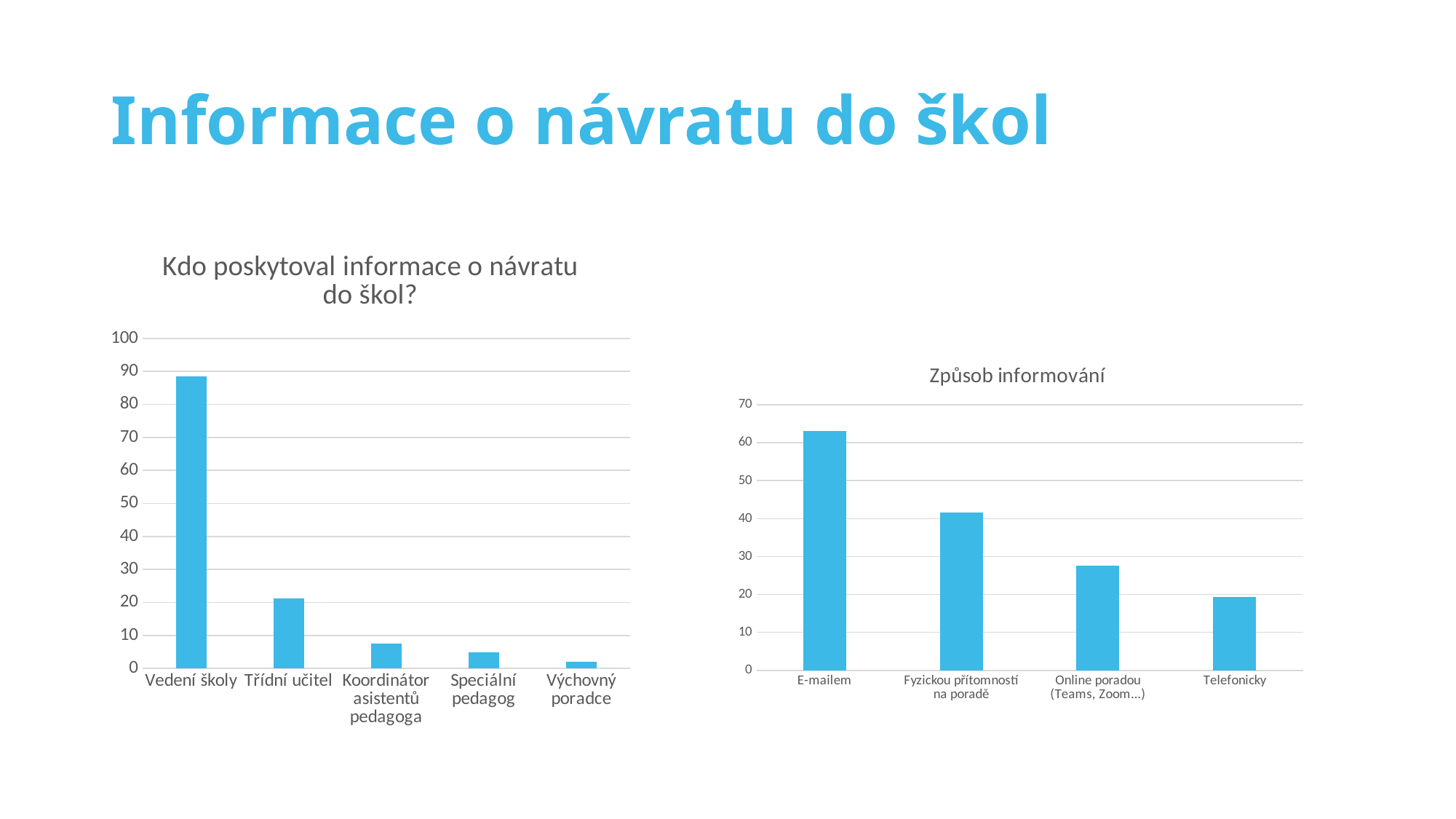
In the chart 'Kdo poskytoval informace o návratu do škol?', which category has the highest value? Vedení školy In the chart 'Způsob informování', which is larger: Fyzickou přítomností na poradě or Telefonicky? Fyzickou přítomností na poradě In the chart 'Kdo poskytoval informace o návratu do škol?', how many categories are shown? 5 In the chart 'Způsob informování', is the value for Online poradou (Teams, Zoom…) greater or less than 30? less In the chart 'Způsob informování', is the value for E-mailem greater or less than 60? greater In the chart 'Způsob informování', which category has the lowest value? Telefonicky In the chart 'Kdo poskytoval informace o návratu do škol?', do the values rise or fall from left to right? fall In the chart 'Způsob informování', which category has the highest value? E-mailem In the chart 'Kdo poskytoval informace o návratu do škol?', is the value for Třídní učitel greater or less than 30? less What kind of chart is 'Způsob informování'? bar chart In the chart 'Kdo poskytoval informace o návratu do škol?', which category has the lowest value? Výchovný poradce